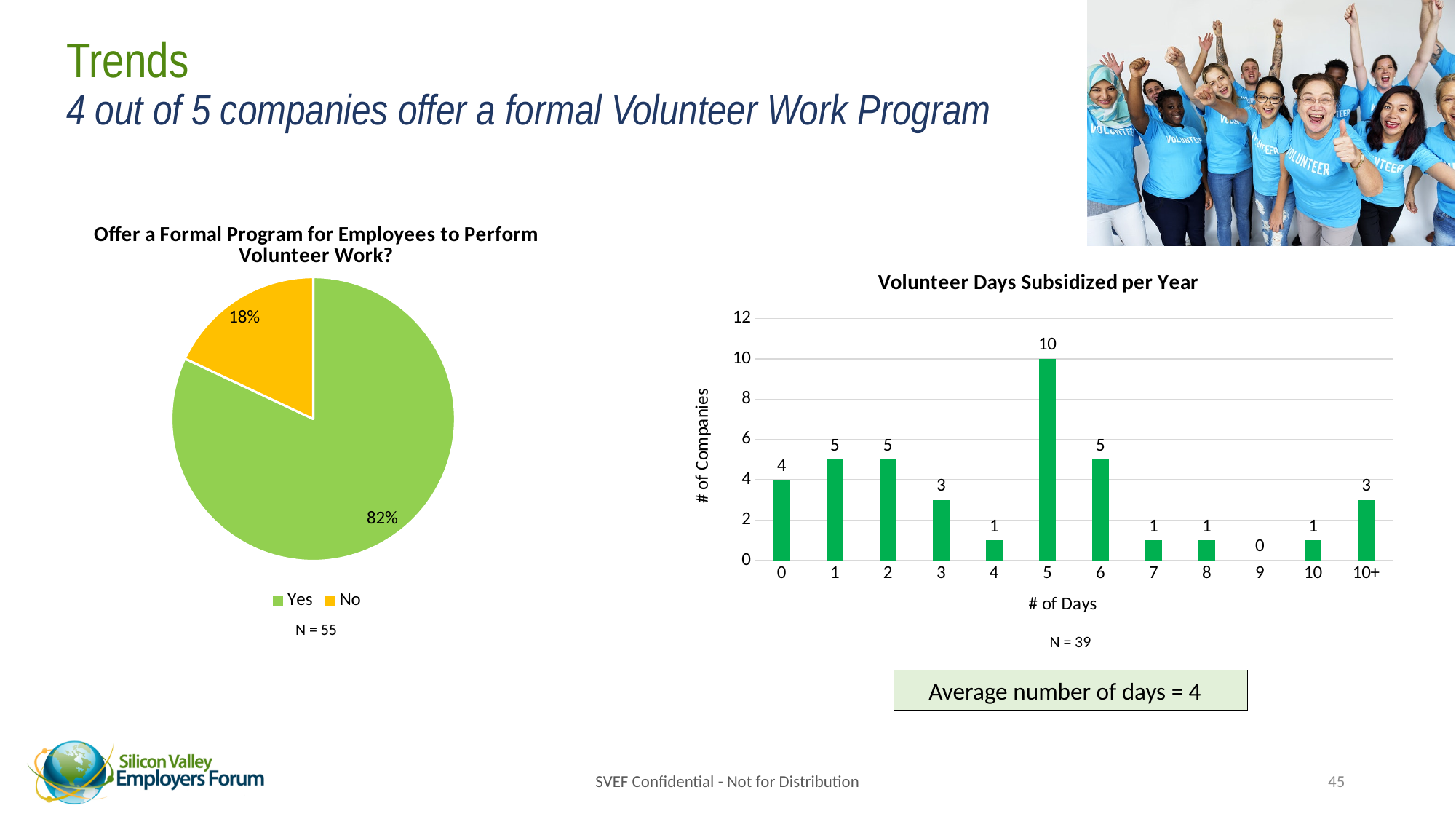
In the pie chart 'Offer a Formal Program for Employees to Perform Volunteer Work?', what is the difference in percentage points between the Yes and No slices? 64 percentage points In the 'Volunteer Days Subsidized per Year' chart, which number of days has the highest number of companies? 5 In the 'Volunteer Days Subsidized per Year' chart, what is the label of the y axis? # of Companies In the 'Volunteer Days Subsidized per Year' chart, how many companies subsidize 10+ days? 3 In the pie chart 'Offer a Formal Program for Employees to Perform Volunteer Work?', what share of companies answered Yes? 82% In the pie chart 'Offer a Formal Program for Employees to Perform Volunteer Work?', what share of companies answered No? 18% In the pie chart 'Offer a Formal Program for Employees to Perform Volunteer Work?', which slice is larger, Yes or No? Yes What type of chart is 'Volunteer Days Subsidized per Year'? Bar chart In the 'Volunteer Days Subsidized per Year' chart, what is the difference between the number of companies at 5 days and at 6 days? 5 In the 'Volunteer Days Subsidized per Year' chart, which number of days has the lowest number of companies? 9 In the 'Volunteer Days Subsidized per Year' chart, how many categories are shown on the x axis? 12 In the 'Volunteer Days Subsidized per Year' chart, how many companies subsidize 5 days? 10